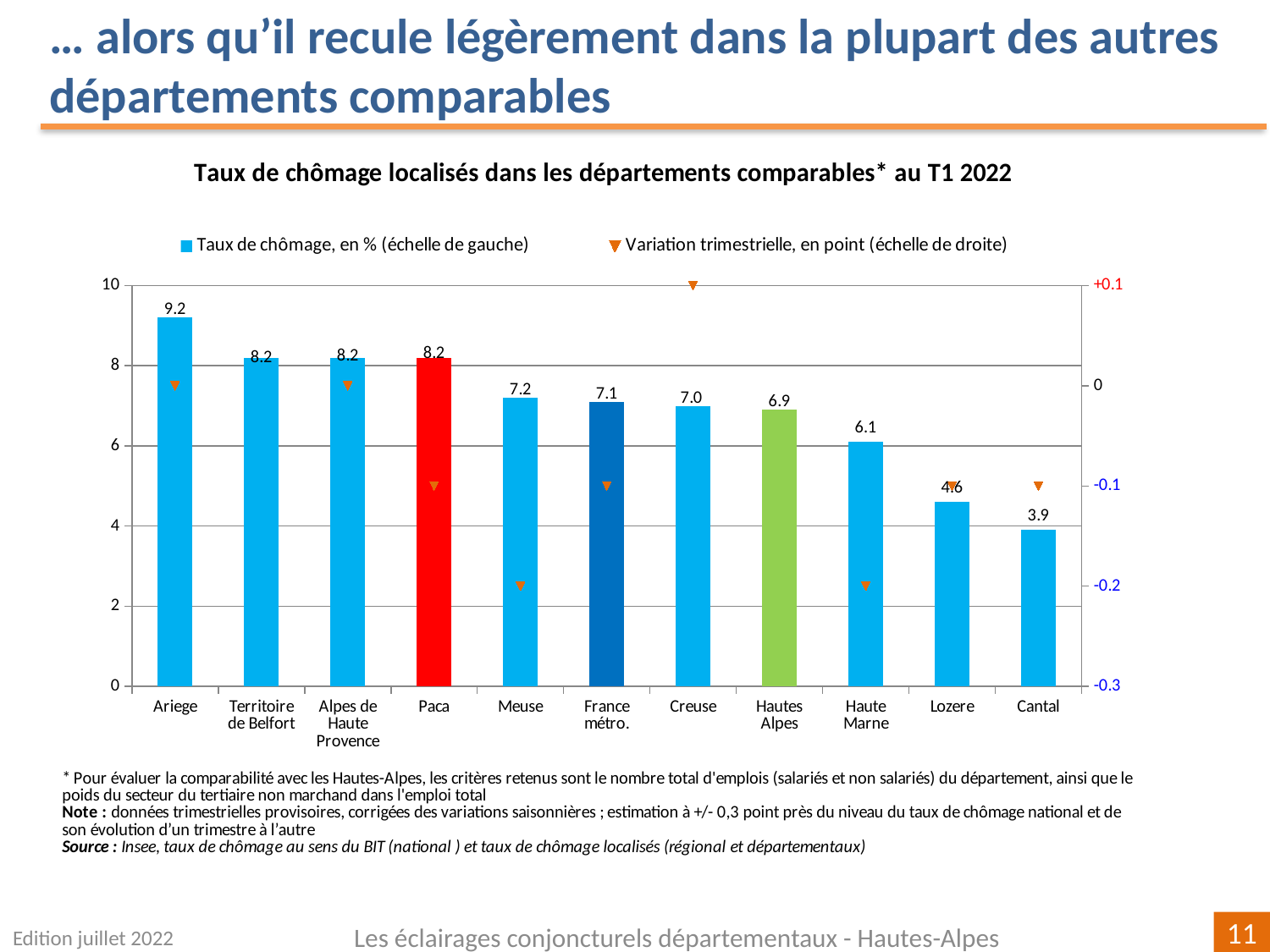
What is the unemployment rate shown for Hautes Alpes? 6.9 Which category has the lowest unemployment rate on the chart? Cantal What kind of chart is used to show the unemployment rates? bar chart Is the quarterly variation for Creuse greater or less than 0? greater Which has a higher unemployment rate, Meuse or Haute Marne? Meuse How many departments/categories are shown on the x axis? 11 What is the difference between the unemployment rates of Ariege and Cantal? 5.3 What is the unemployment rate (taux de chômage) shown for Ariege? 9.2 Is the quarterly variation (variation trimestrielle) for Meuse greater or less than -0.1? less How many series does the legend list? 2 Which department has the highest unemployment rate on the chart? Ariege What is the unemployment rate shown for Cantal? 3.9